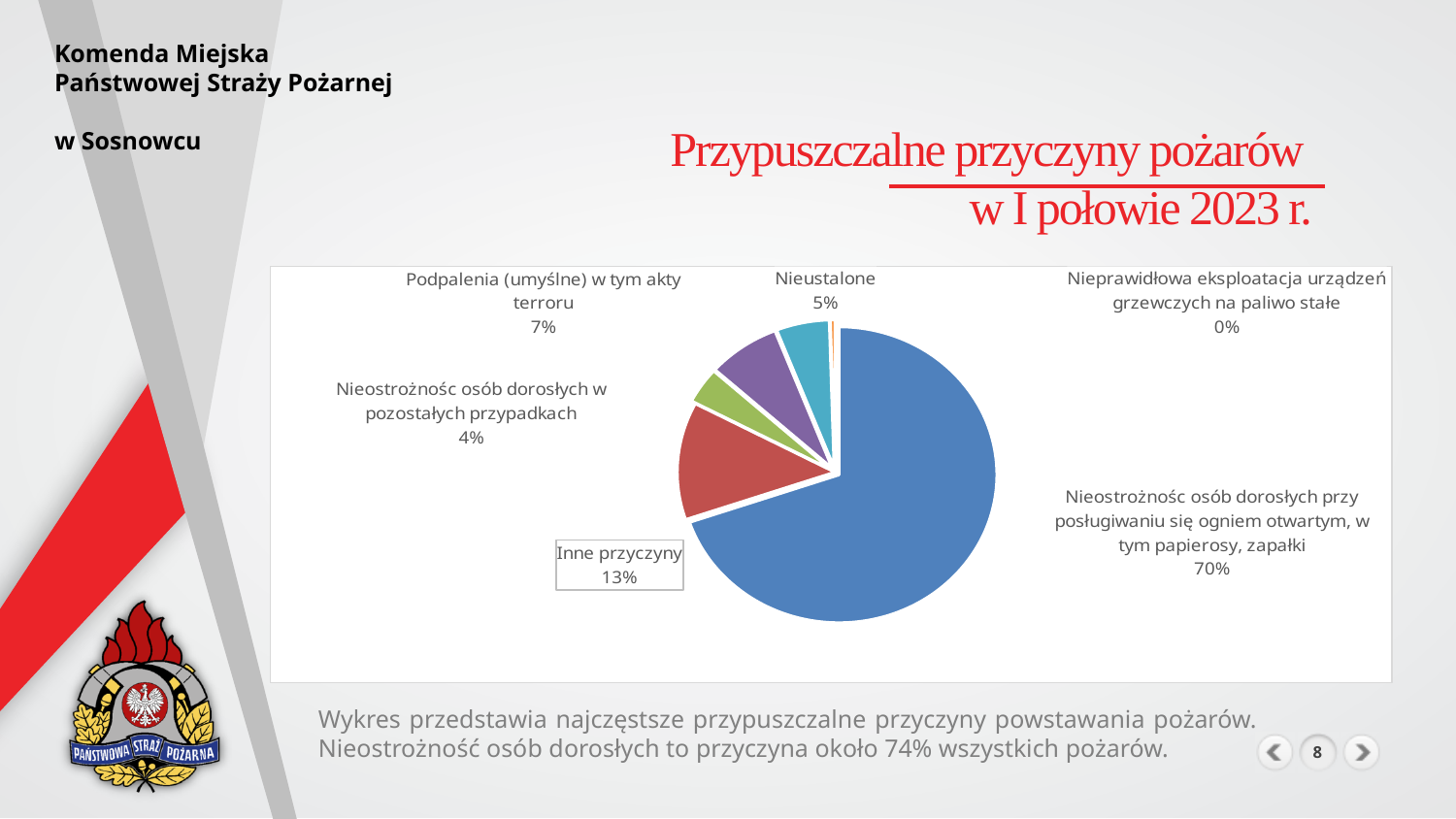
What is the difference in percentage points between "Inne przyczyny" and "Podpalenia (umyślne) w tym akty terroru"? 6 What share of the pie does "Nieostrożność osób dorosłych przy posługiwaniu się ogniem otwartym, w tym papierosy, zapałki" have? 70% Which category has the smallest share of the pie? Nieprawidłowa eksploatacja urządzeń grzewczych na paliwo stałe What value is shown for "Nieostrożność osób dorosłych w pozostałych przypadkach"? 4% How many categories are shown in the pie chart? 6 What share of the pie does "Inne przyczyny" have? 13% What value is shown for "Nieustalone"? 5% Which is larger: the share for "Nieustalone" or the share for "Nieostrożność osób dorosłych w pozostałych przypadkach"? Nieustalone What type of chart is shown on the slide? Pie chart Which category has the largest share of the pie? Nieostrożność osób dorosłych przy posługiwaniu się ogniem otwartym, w tym papierosy, zapałki What value is shown for "Podpalenia (umyślne) w tym akty terroru"? 7% What value is shown for "Nieprawidłowa eksploatacja urządzeń grzewczych na paliwo stałe"? 0%